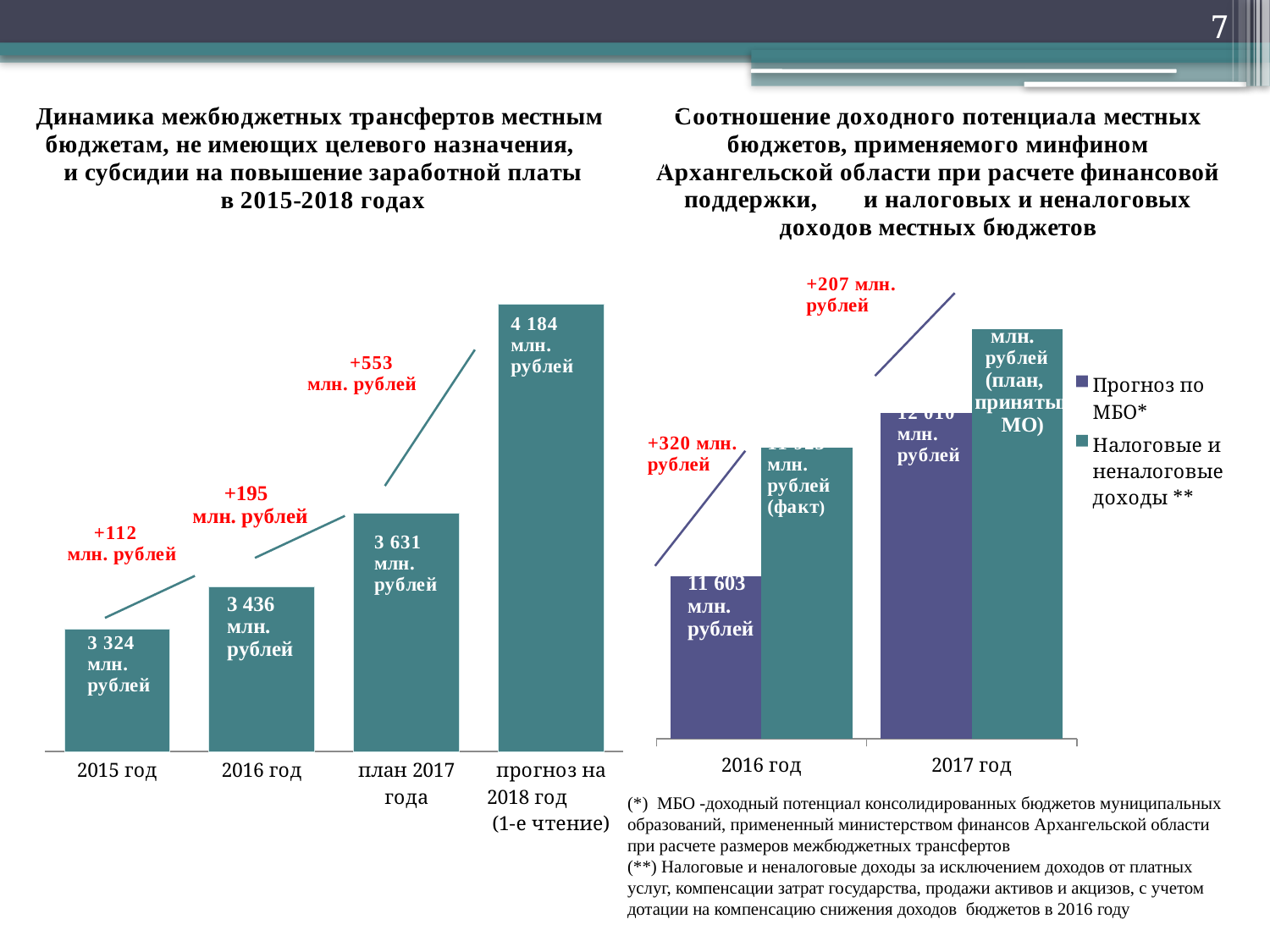
In the left chart (Динамика межбюджетных трансфертов), which category has the highest value? прогноз на 2018 год (1-е чтение) In the left chart (Динамика межбюджетных трансфертов), what is the value for 2015 год? 3 324 млн. рублей In the left chart (Динамика межбюджетных трансфертов), what is the difference between the values for 2016 год and 2015 год? 112 млн. рублей In the left chart (Динамика межбюджетных трансфертов), which category has the lowest value? 2015 год In the right chart (Соотношение доходного потенциала), for 2016 год, which is larger: Прогноз по МБО or Налоговые и неналоговые доходы? Налоговые и неналоговые доходы In the left chart (Динамика межбюджетных трансфертов), do the values rise or fall from 2015 год to прогноз на 2018 год? rise In the right chart (Соотношение доходного потенциала), how many series does the legend list? 2 In the right chart (Соотношение доходного потенциала), what is the value of Прогноз по МБО for 2016 год? 11 603 млн. рублей In the left chart (Динамика межбюджетных трансфертов), how many categories are shown on the x axis? 4 In the left chart (Динамика межбюджетных трансфертов), what is the difference between the values for прогноз на 2018 год and план 2017 года? 553 млн. рублей What kind of chart is the left chart (Динамика межбюджетных трансфертов)? bar chart In the left chart (Динамика межбюджетных трансфертов), what is the value for план 2017 года? 3 631 млн. рублей